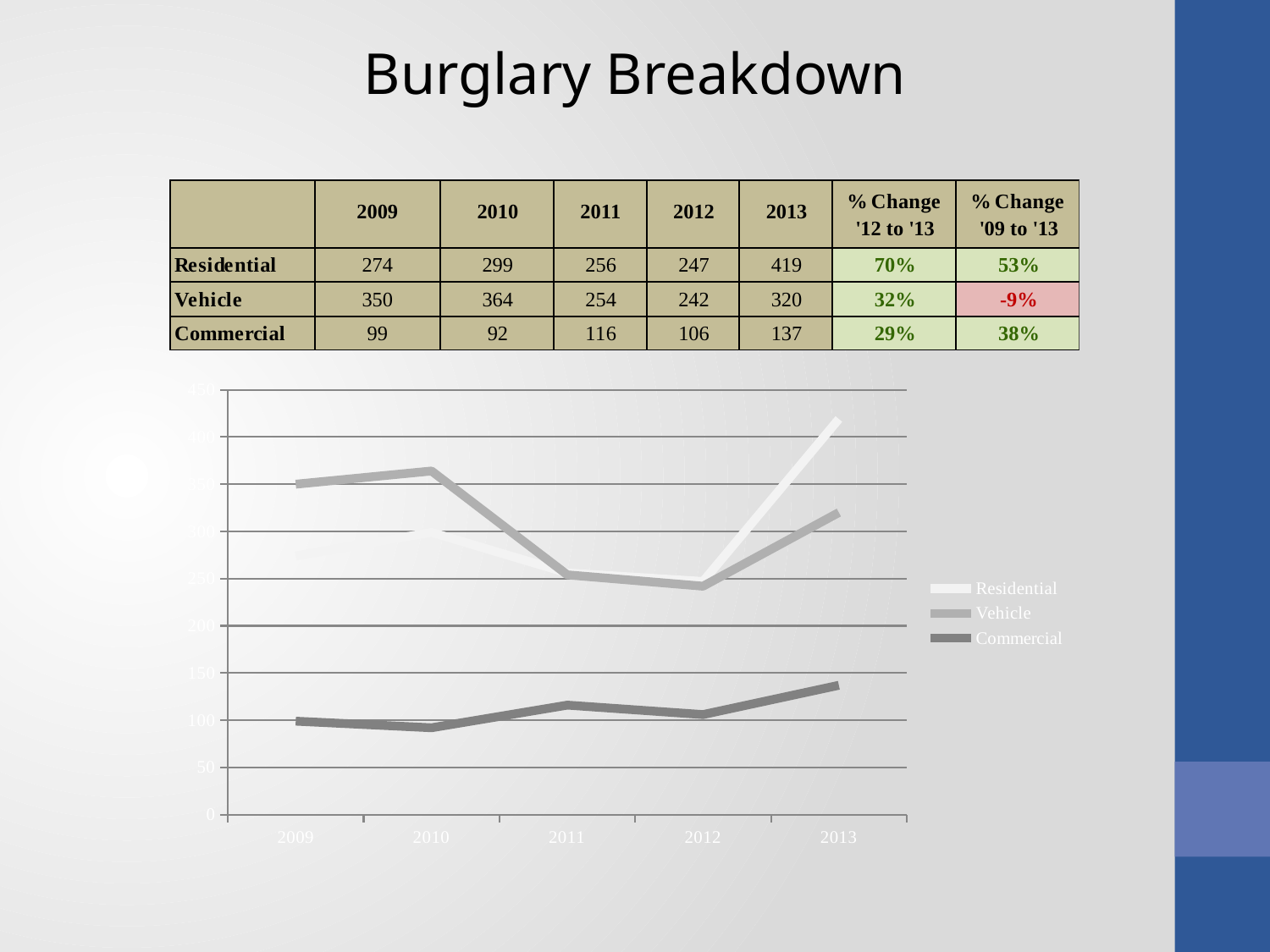
What is the Residential value for 2013? 419 What kind of chart is shown on the slide? line chart Which series has the lowest value on the chart? Commercial What is the Vehicle value for 2011? 254 How many series does the chart's legend list? 3 Which series reaches the highest value on the chart, and in which year? Residential, 2013 How many years are plotted along the x axis of the chart? 5 Is the Vehicle value for 2013 greater or less than 300? greater In 2009, which is larger: the Vehicle value or the Residential value? Vehicle Does the Residential line rise or fall from 2012 to 2013? rise What is the difference between the Residential values for 2013 and 2012? 172 What is the Commercial value for 2010? 92